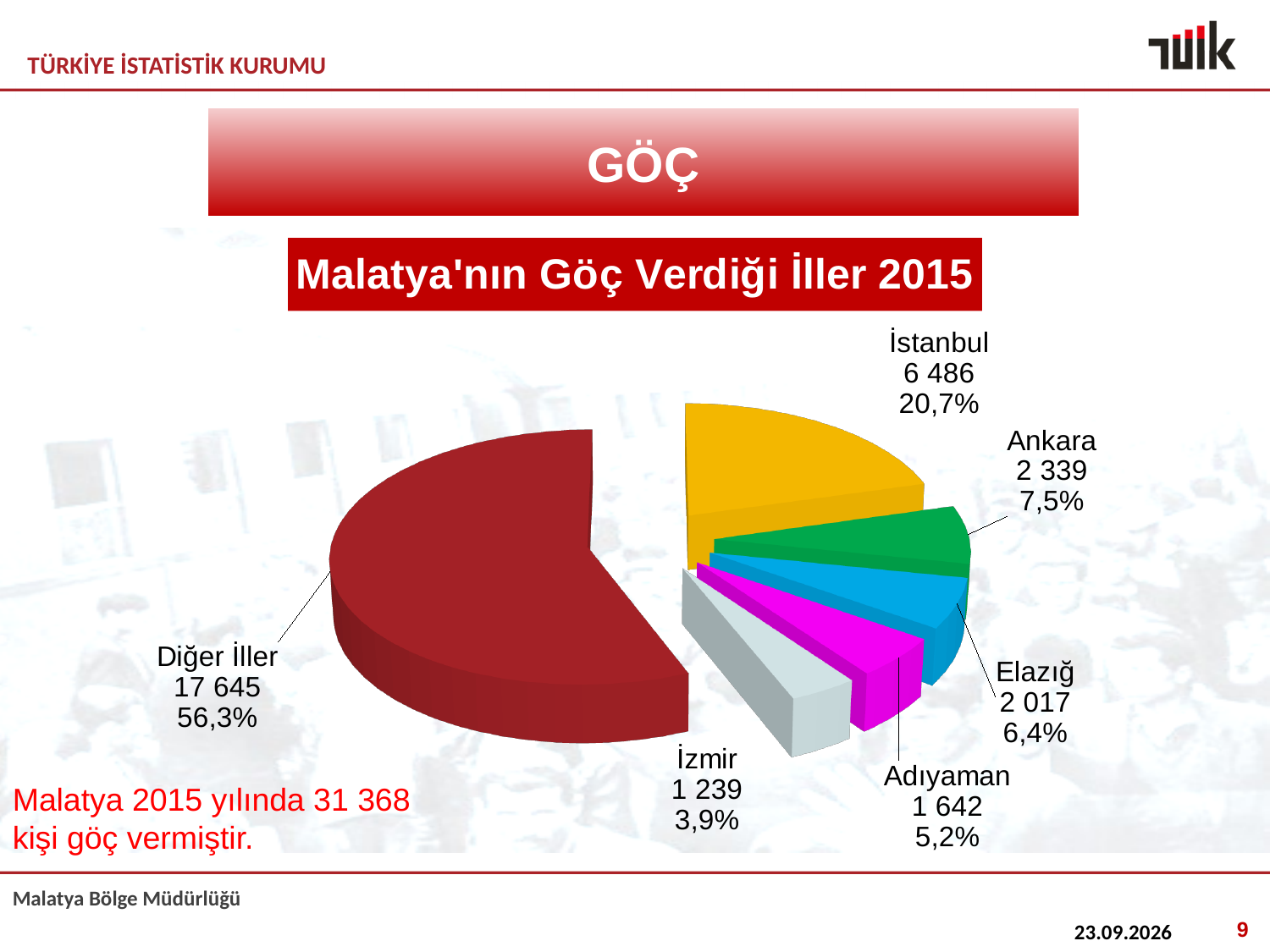
What kind of chart is shown on the slide? pie chart What is the value shown for İstanbul? 6 486 What is the value shown for İzmir? 1 239 Which slice has the smallest value? İzmir What is the value shown for Adıyaman? 1 642 How many slices does the pie chart have? 6 What is the difference between the values for Ankara and Elazığ? 322 Which slice has the largest value? Diğer İller What is the value shown for Ankara? 2 339 What share of the pie does İstanbul represent? 20,7% What is the value shown for Elazığ? 2 017 What is the title of the chart? Malatya'nın Göç Verdiği İller 2015